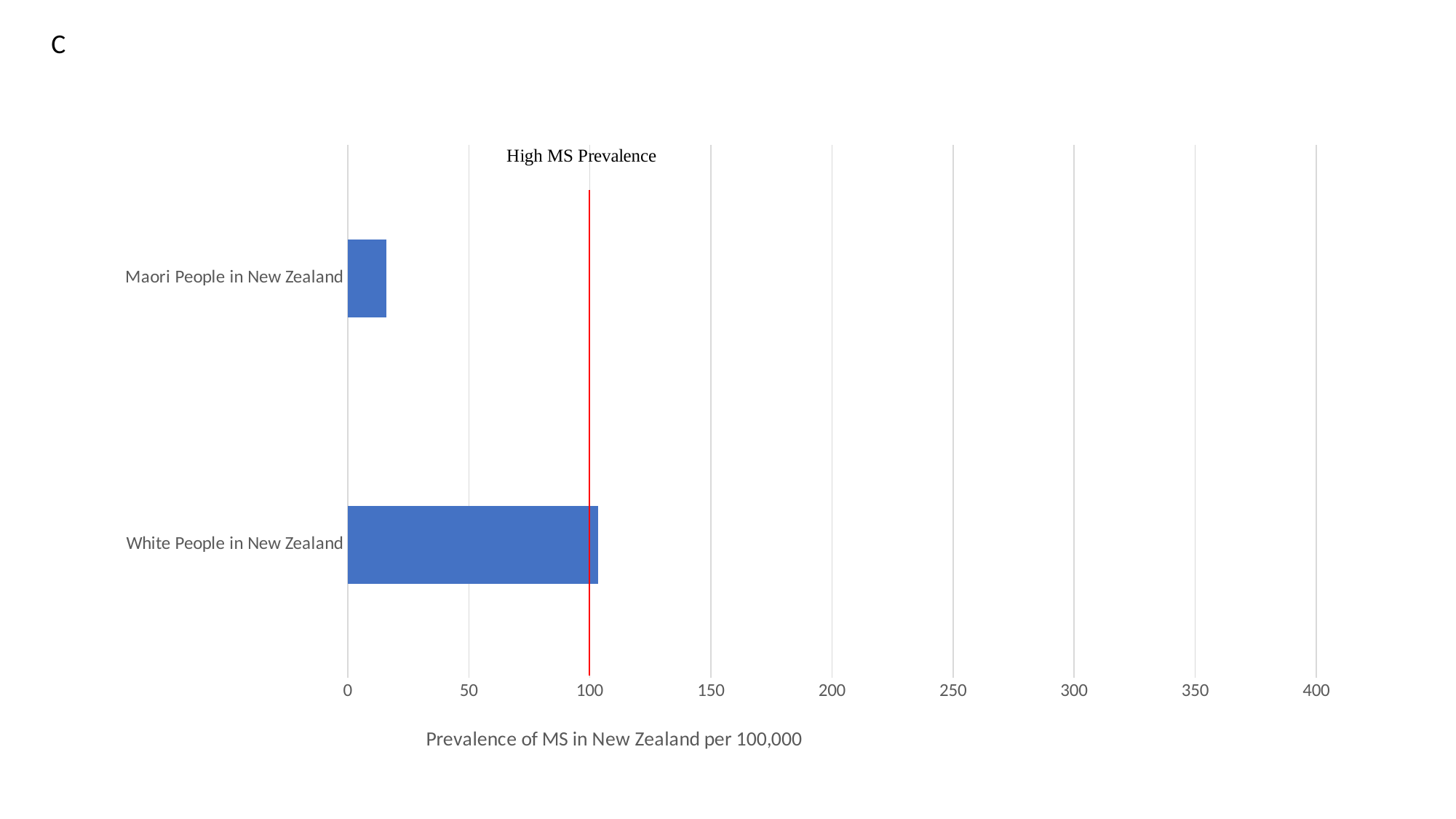
Is the value for Maori People in New Zealand greater or less than 50? less How many categories are plotted in the chart? 2 What is the maximum value shown on the x axis? 400 What is the x-axis title of the chart? Prevalence of MS in New Zealand per 100,000 Which is larger, the value for White People in New Zealand or the value for Maori People in New Zealand? White People in New Zealand What kind of chart is shown on the slide? bar chart Which category has the lowest MS prevalence? Maori People in New Zealand Is the value for White People in New Zealand greater or less than 50? greater Which category has the highest MS prevalence? White People in New Zealand Is the value for White People in New Zealand greater or less than 150? less What label is written above the red vertical line in the chart? High MS Prevalence